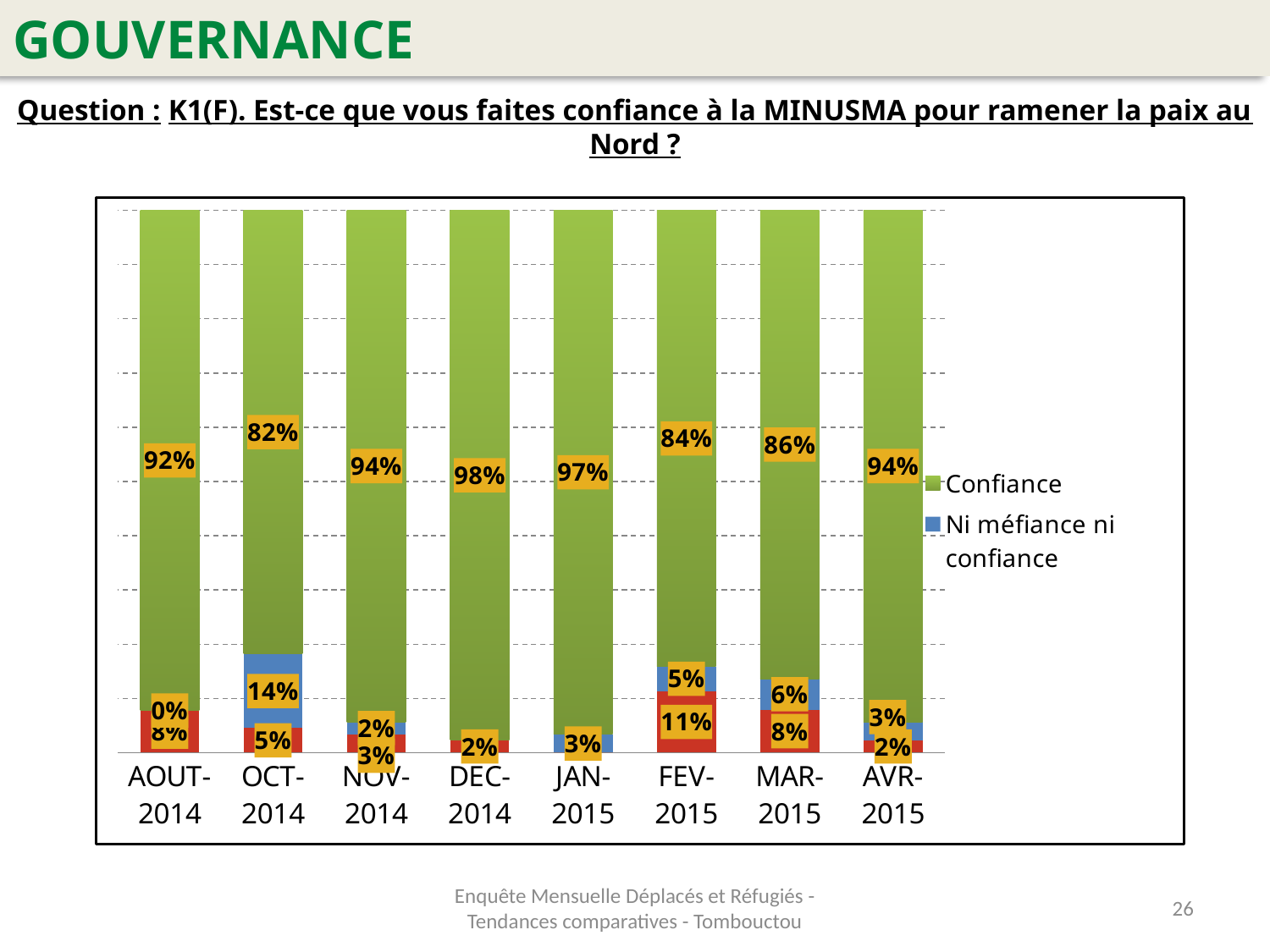
Which month has the lowest Confiance value? OCT-2014 What kind of chart is shown on the slide? Stacked bar chart What is the Confiance value for AVR-2015? 94% How many months are shown on the x axis? 8 Which month has the larger Confiance value, FEV-2015 or MAR-2015? MAR-2015 Which month has the highest Confiance value? DEC-2014 What is the 'Ni méfiance ni confiance' value for OCT-2014? 14% What colour represents the Confiance series? Green What is the difference between the Confiance values for DEC-2014 and OCT-2014? 16 percentage points What is the Confiance value for DEC-2014? 98% What is the Confiance value for OCT-2014? 82% What is the 'Ni méfiance ni confiance' value for MAR-2015? 6%